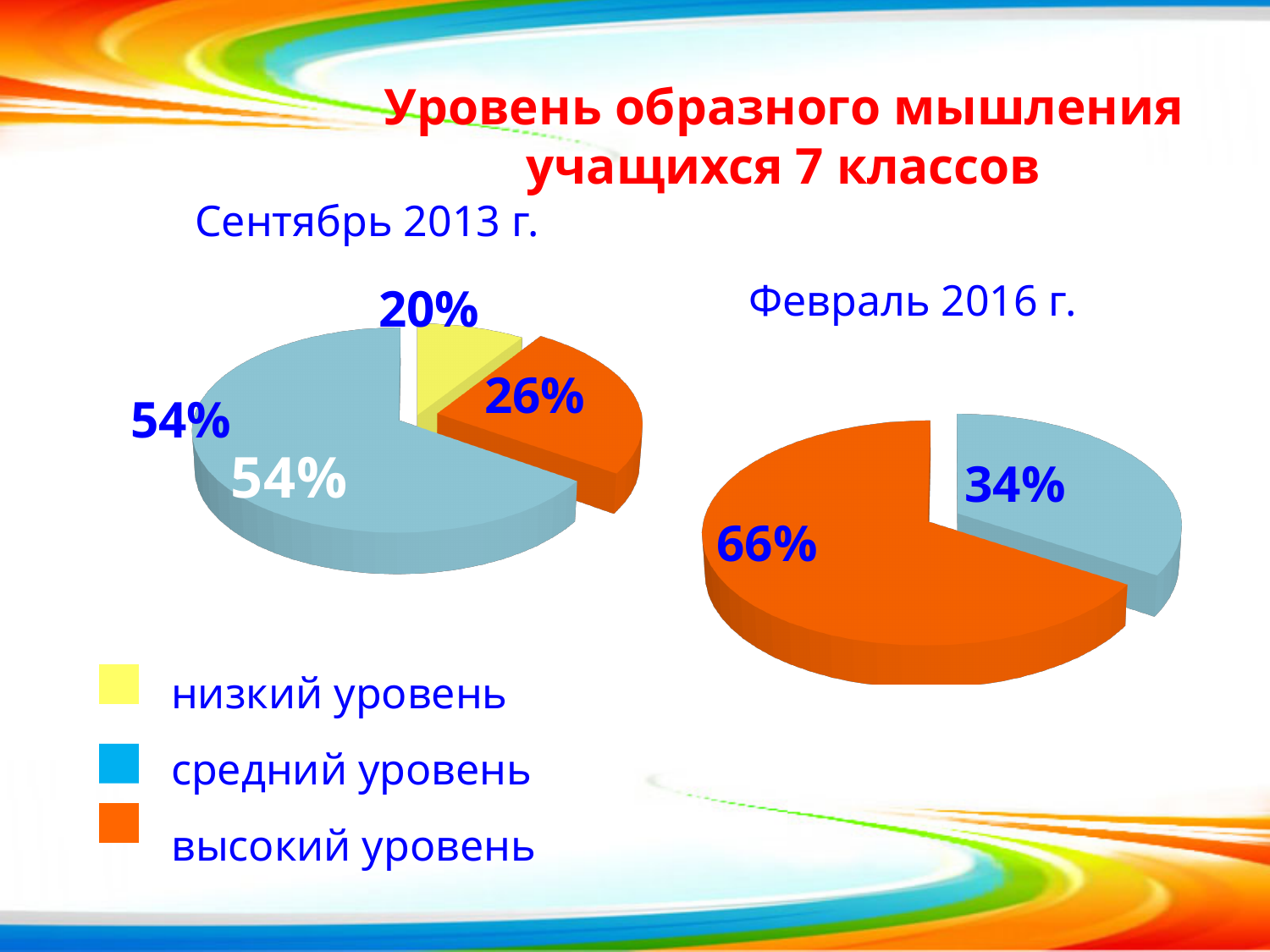
How many slices does the "Февраль 2016 г." chart have? 2 In the "Февраль 2016 г." chart, what share is the средний уровень slice? 34% In the "Сентябрь 2013 г." chart, what share is the высокий уровень slice? 26% In the "Сентябрь 2013 г." chart, which level has the largest slice? средний уровень In the "Сентябрь 2013 г." chart, what share is the средний уровень slice? 54% In the "Сентябрь 2013 г." chart, which level has the smallest slice? низкий уровень What is the difference between the высокий уровень share in the "Февраль 2016 г." chart and in the "Сентябрь 2013 г." chart? 40% How many slices does the "Сентябрь 2013 г." chart have? 3 In the "Февраль 2016 г." chart, what share is the высокий уровень slice? 66% What type of chart is used on this slide? Pie chart In the "Сентябрь 2013 г." chart, what share is the низкий уровень slice? 20% In the "Февраль 2016 г." chart, which level has the larger slice? высокий уровень